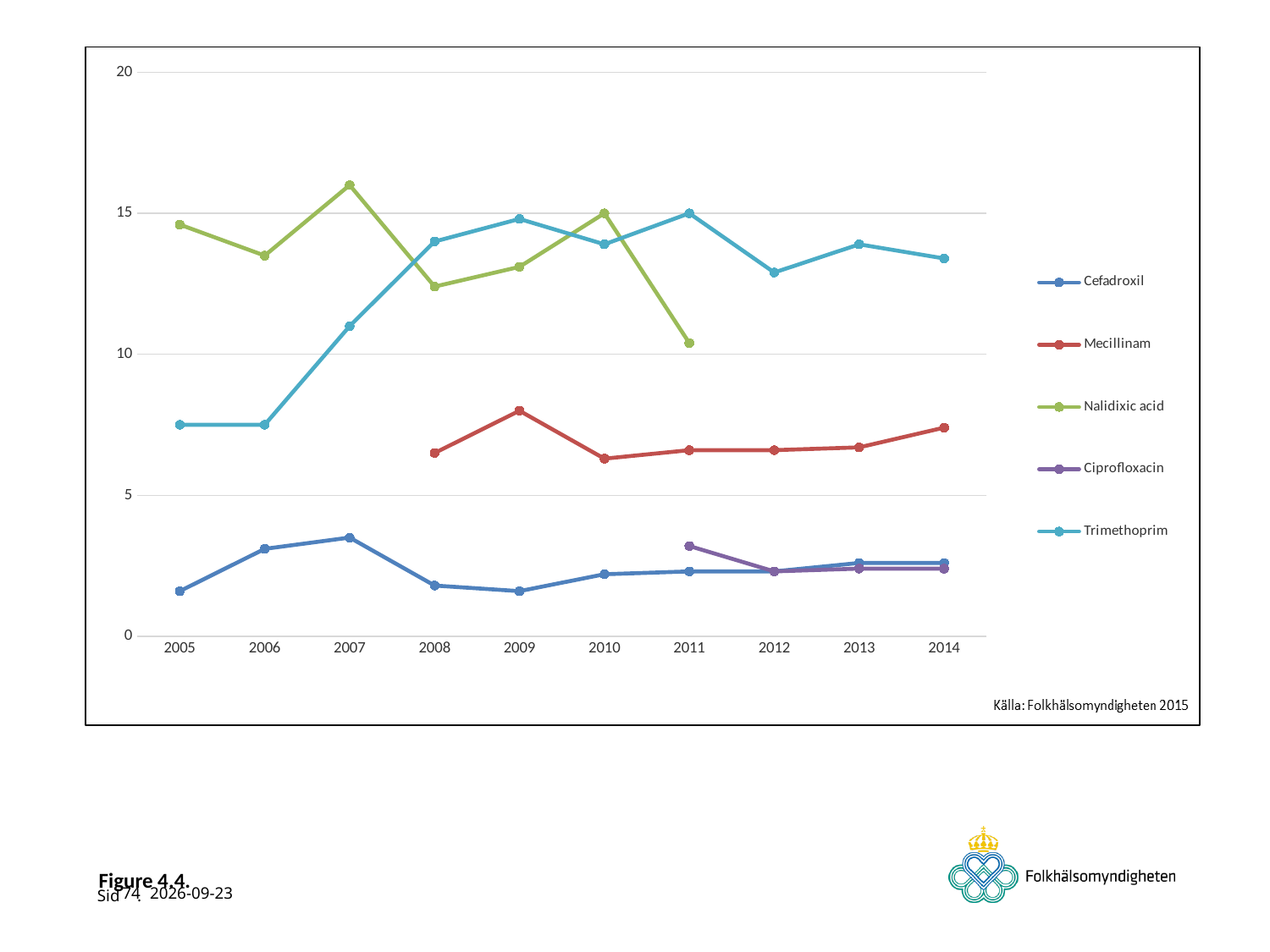
What source is cited at the bottom of the chart? Källa: Folkhälsomyndigheten 2015 How many series does the legend list? 5 How many years are shown on the x axis? 10 Which series has the highest value in 2007? Nalidixic acid In 2011, which is larger: Trimethoprim or Nalidixic acid? Trimethoprim Does the Trimethoprim line rise or fall from 2006 to 2009? rise What kind of chart is shown on the slide? line chart Is the value for Cefadroxil in 2007 greater or less than 5? less Is the value for Mecillinam in 2009 greater or less than 10? less Is the value for Trimethoprim in 2005 greater or less than 10? less Which series has the lowest value in 2005? Cefadroxil